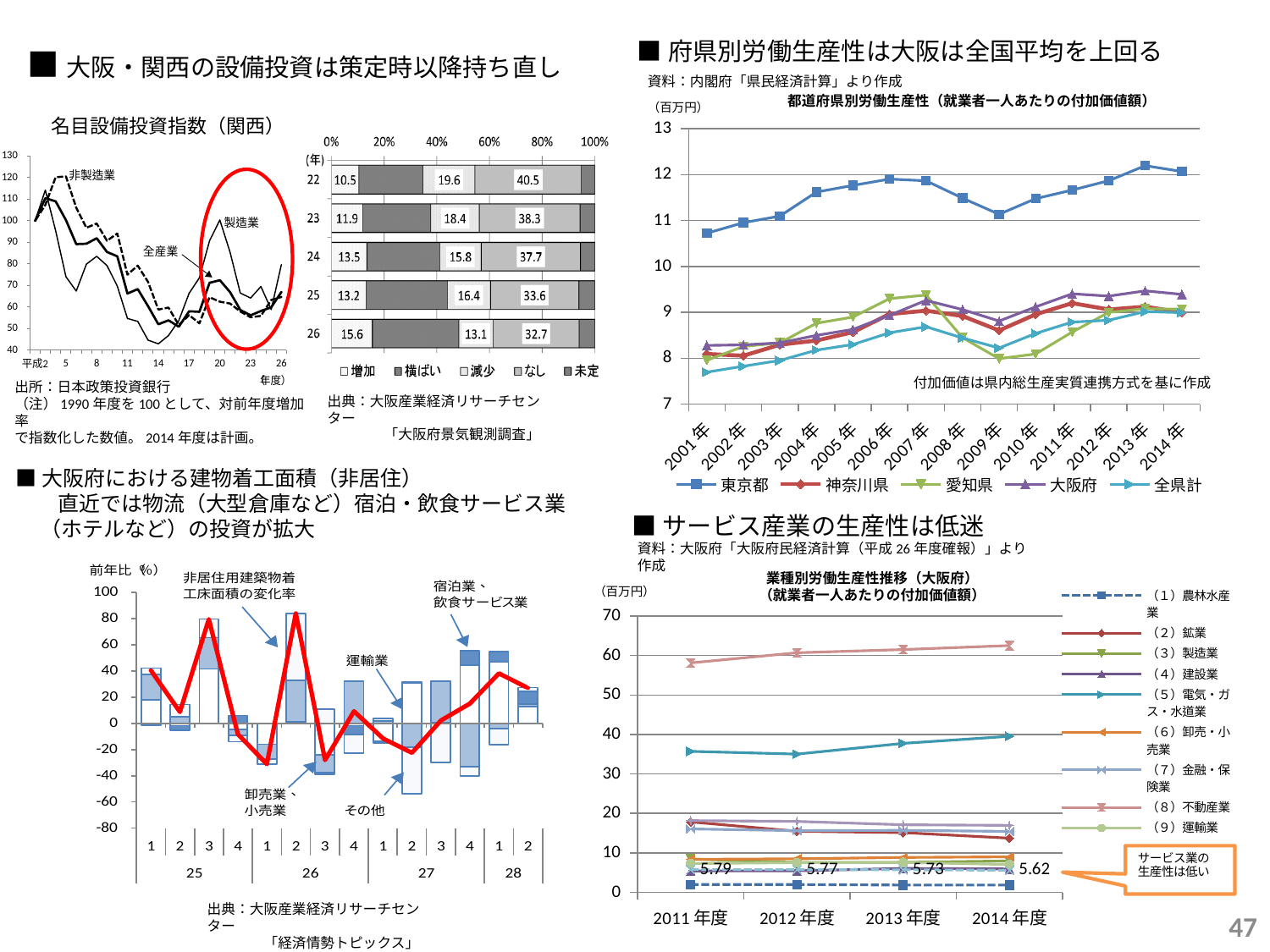
In the chart titled 都道府県別労働生産性（就業者一人あたりの付加価値額）, which series has the highest values? 東京都 In the chart titled 都道府県別労働生産性（就業者一人あたりの付加価値額）, how many years are plotted on the x axis? 14 In the stacked bar chart in the top middle of the slide, what is the value of 増加 for 26年? 15.6 In the chart titled 都道府県別労働生産性（就業者一人あたりの付加価値額）, is the value for 東京都 in 2001年 greater or less than 11? less In the stacked bar chart in the top middle of the slide, which year has the highest value for 増加? 26年 In the chart titled 業種別労働生産性推移（大阪府）, how many series does the legend list? 9 In the stacked bar chart in the top middle of the slide, how many series does the legend list? 5 In the chart titled 業種別労働生産性推移（大阪府）, which series has the highest values? （8）不動産業 In the stacked bar chart in the top middle of the slide, what is the difference between the 増加 values for 26年 and 22年? 5.1 In the stacked bar chart in the top middle of the slide, what is the value of 増加 for 22年? 10.5